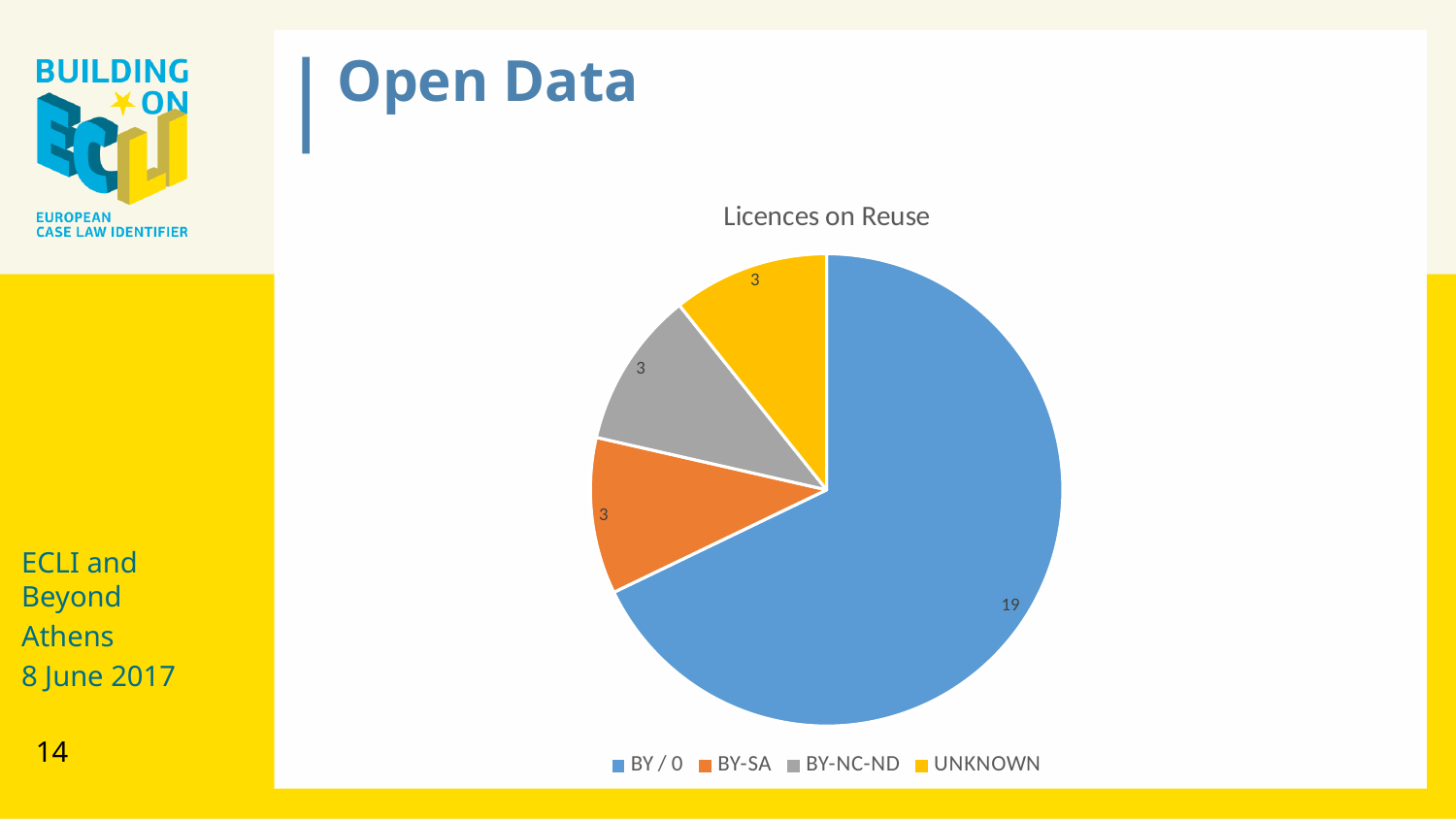
What is the value for UNKNOWN in the Licences on Reuse chart? 3 How many categories does the legend of the pie chart list? 4 What is the value for BY / 0 in the Licences on Reuse chart? 19 Which licence category has the largest slice in the pie chart? BY / 0 What is the title of the chart? Licences on Reuse What type of chart is shown on the slide? pie chart What is the total of all the slices in the Licences on Reuse pie chart? 28 What is the difference between the values for BY / 0 and BY-SA? 16 What colour is the BY-SA slice in the pie chart? orange What is the value for BY-NC-ND in the Licences on Reuse chart? 3 What is the value for BY-SA in the Licences on Reuse chart? 3 Which is larger, the value for BY / 0 or the value for UNKNOWN? BY / 0